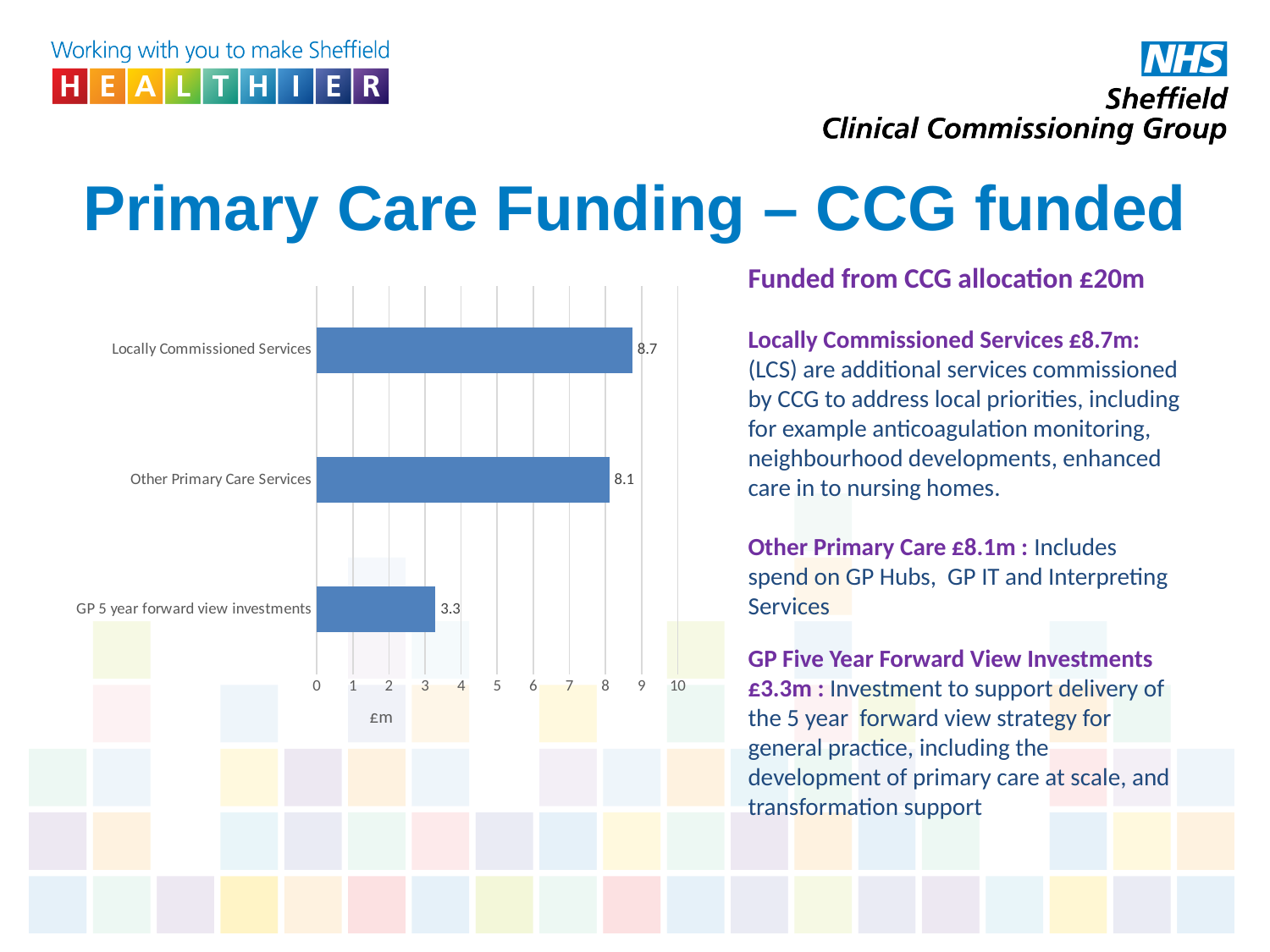
How many categories are shown in the chart? 3 What is the difference between the values for Locally Commissioned Services and Other Primary Care Services? 0.6 What is the value for GP 5 year forward view investments? 3.3 Which category has the highest value? Locally Commissioned Services Which category has the lowest value? GP 5 year forward view investments What kind of chart is shown on the slide? bar chart What is the label on the horizontal axis of the chart? £m What is the difference between the values for Other Primary Care Services and GP 5 year forward view investments? 4.8 Is the value for GP 5 year forward view investments greater or less than 4? less What is the value for Other Primary Care Services? 8.1 Which is larger, the value for Other Primary Care Services or the value for GP 5 year forward view investments? Other Primary Care Services What is the value for Locally Commissioned Services? 8.7